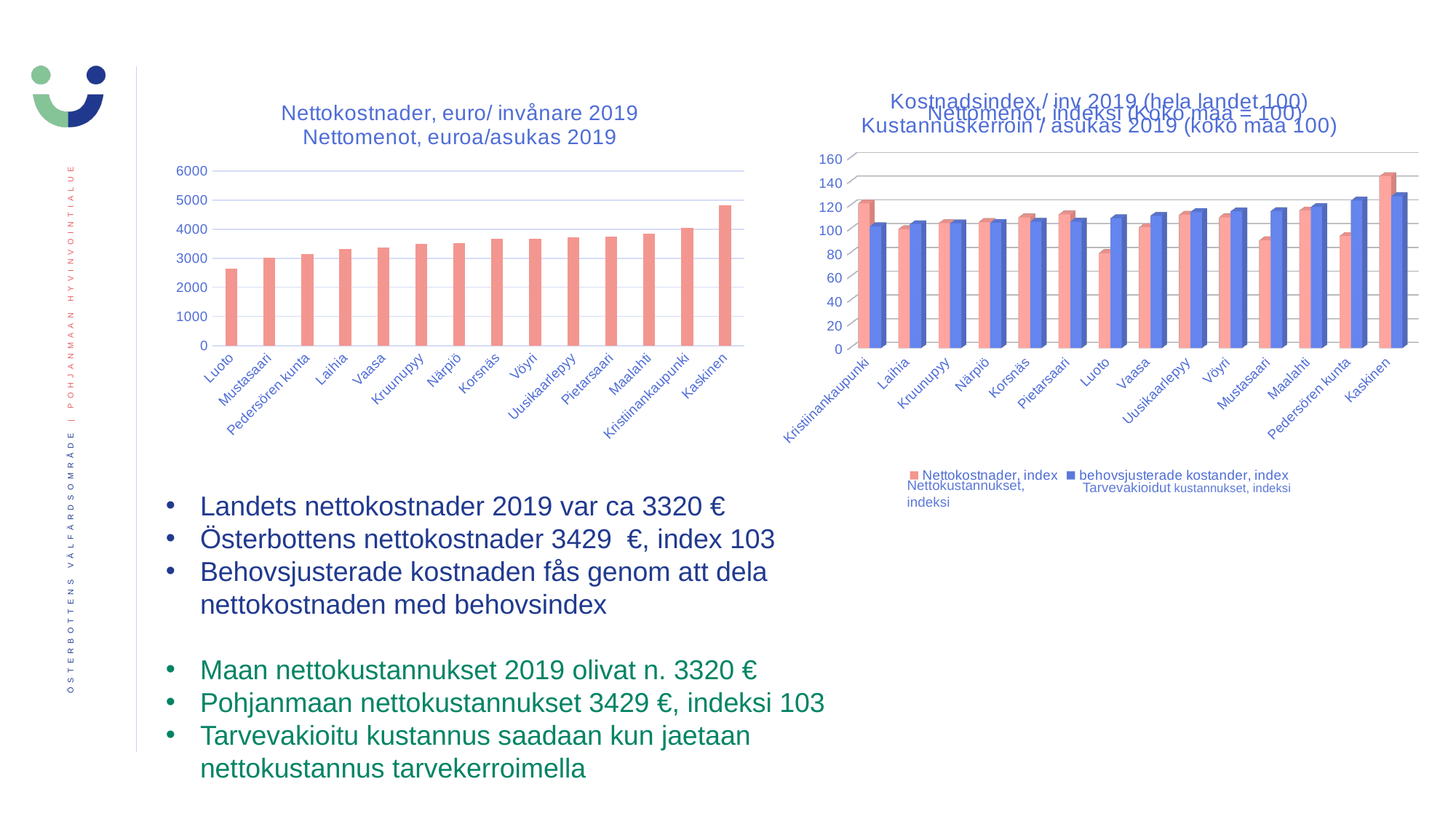
In the right chart (the index chart), which municipality has the highest 'Nettokostnader, index' value? Kaskinen What kind of chart is the left chart titled 'Nettokostnader, euro/ invånare 2019'? bar chart In the left chart 'Nettokostnader, euro/ invånare 2019', is the value for Kaskinen greater or less than 4000? greater In the right chart (the index chart), which municipality has the lowest 'Nettokostnader, index' value? Luoto How many series does the legend of the right chart (the index chart) list? 2 In the left chart 'Nettokostnader, euro/ invånare 2019', which municipality has the highest value? Kaskinen In the left chart 'Nettokostnader, euro/ invånare 2019', which municipality has the lowest value? Luoto In the left chart 'Nettokostnader, euro/ invånare 2019', is the value for Luoto greater or less than 3000? less In the right chart (the index chart), for Pedersören kunta, which series has the larger value: 'Nettokostnader, index' or 'behovsjusterade kostander, index'? behovsjusterade kostander, index In the left chart 'Nettokostnader, euro/ invånare 2019', how many municipalities are shown on the x axis? 14 In the left chart 'Nettokostnader, euro/ invånare 2019', do the values generally rise or fall from left to right along the x axis? rise In the right chart (the index chart), is the 'Nettokostnader, index' value for Luoto greater or less than 100? less